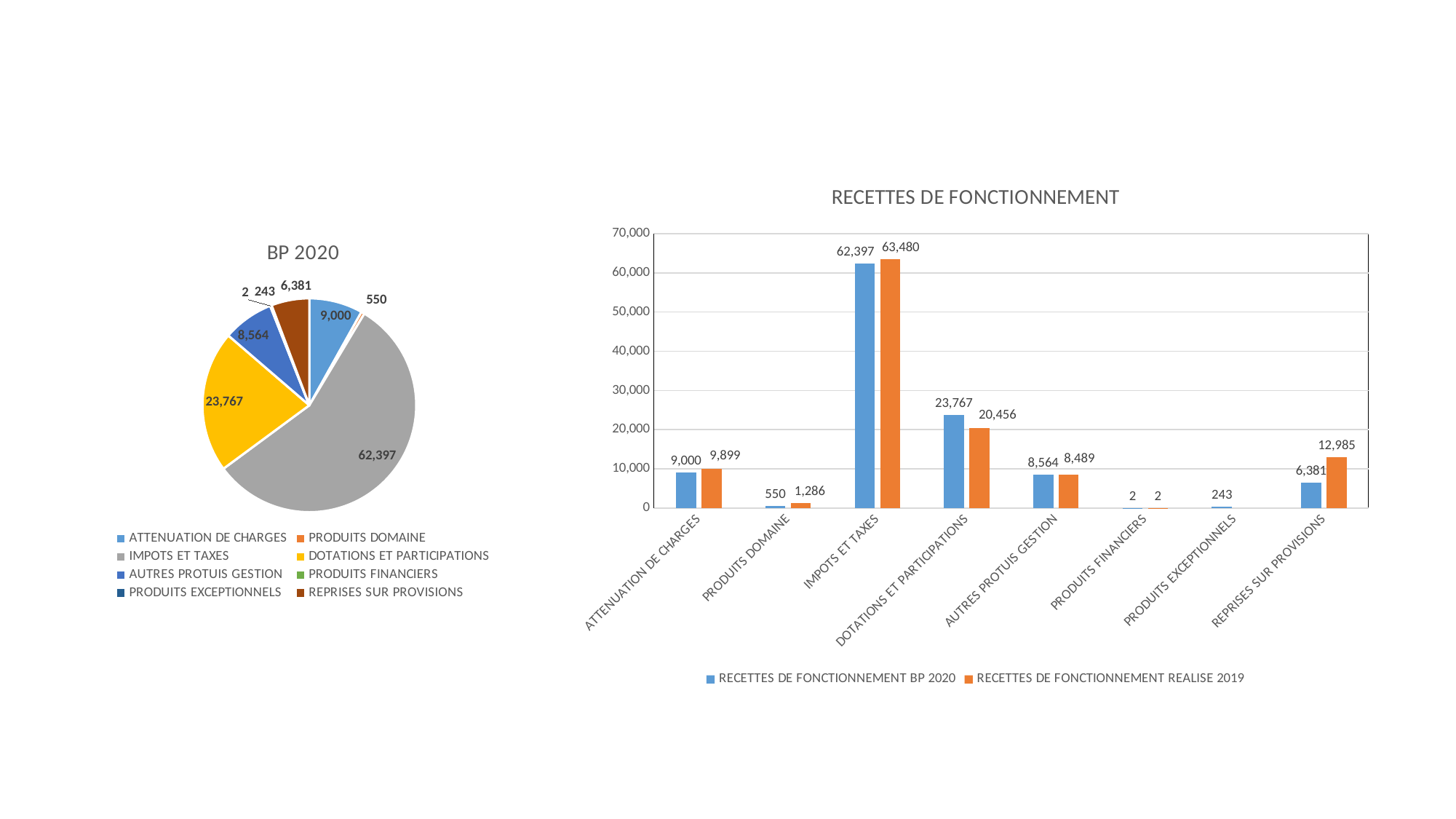
In the RECETTES DE FONCTIONNEMENT bar chart, what is the value of RECETTES DE FONCTIONNEMENT BP 2020 for DOTATIONS ET PARTICIPATIONS? 23,767 In the RECETTES DE FONCTIONNEMENT bar chart, what is the value of RECETTES DE FONCTIONNEMENT REALISE 2019 for IMPOTS ET TAXES? 63,480 In the RECETTES DE FONCTIONNEMENT bar chart, what is the REALISE 2019 value for REPRISES SUR PROVISIONS? 12,985 What type of chart is the chart titled BP 2020? pie chart How many categories are shown on the x axis of the RECETTES DE FONCTIONNEMENT bar chart? 8 In the RECETTES DE FONCTIONNEMENT bar chart, what is the difference between the REALISE 2019 and BP 2020 values for REPRISES SUR PROVISIONS? 6,604 How many series does the legend of the RECETTES DE FONCTIONNEMENT bar chart list? 2 In the BP 2020 pie chart, which category has the smallest slice? PRODUITS FINANCIERS In the BP 2020 pie chart, what is the value of the DOTATIONS ET PARTICIPATIONS slice? 23,767 In the RECETTES DE FONCTIONNEMENT bar chart, which is larger for PRODUITS DOMAINE: BP 2020 or REALISE 2019? REALISE 2019 In the RECETTES DE FONCTIONNEMENT bar chart, what is the difference between the BP 2020 and REALISE 2019 values for DOTATIONS ET PARTICIPATIONS? 3,311 In the RECETTES DE FONCTIONNEMENT bar chart, which category has the highest BP 2020 value? IMPOTS ET TAXES